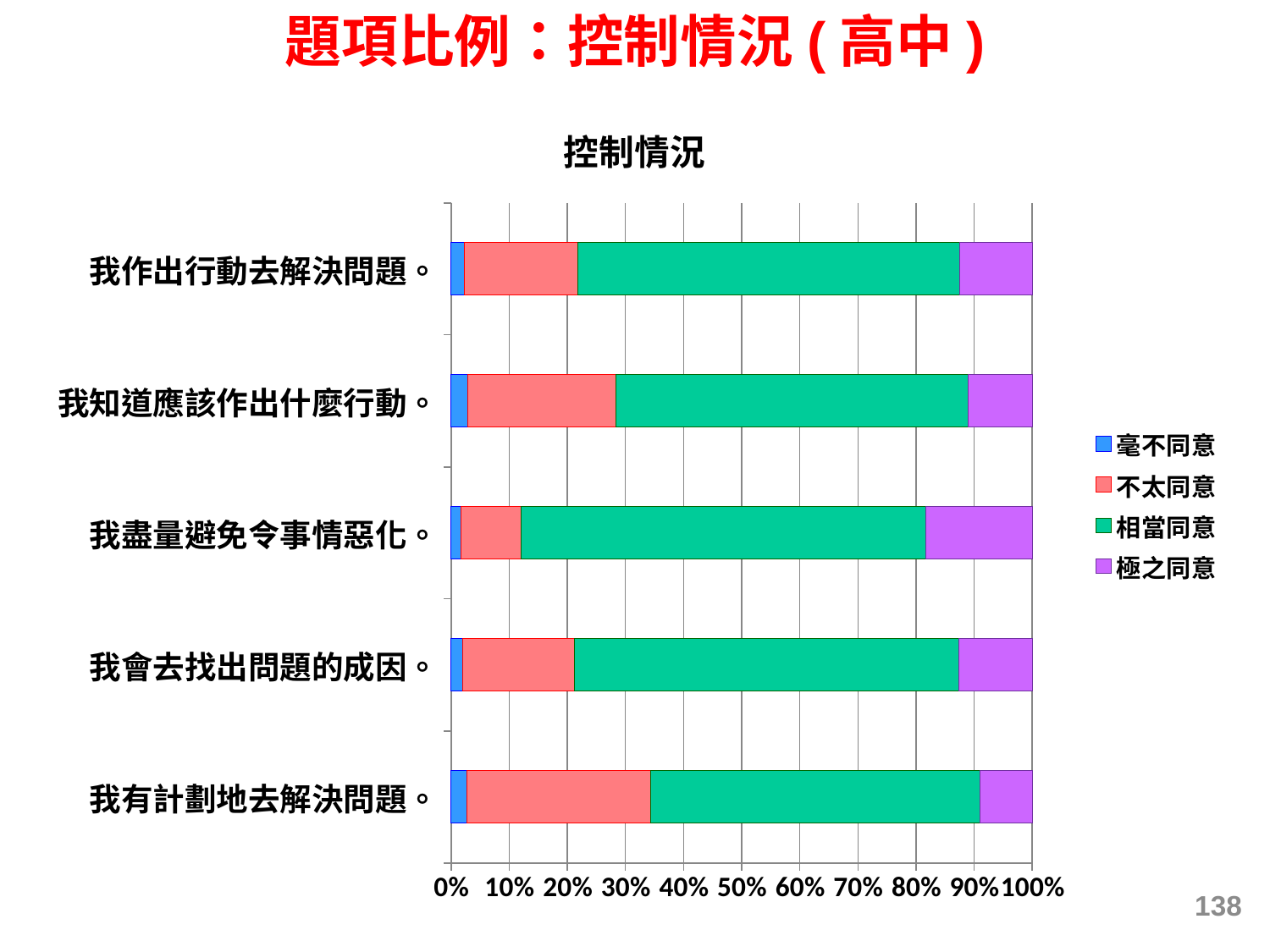
How many statements (categories) are plotted in the chart? 5 What kind of chart is shown on the slide? stacked bar chart What is the title of the chart? 控制情況 Is the 不太同意 share for 我盡量避免令事情惡化 greater or less than 20%? less Which has the larger 不太同意 share: 我有計劃地去解決問題 or 我盡量避免令事情惡化? 我有計劃地去解決問題。 Which statement has the largest 不太同意 share? 我有計劃地去解決問題。 Which legend entry is shown in green? 相當同意 Is the 極之同意 share for 我有計劃地去解決問題 greater or less than 20%? less Which statement has the smallest 不太同意 share? 我盡量避免令事情惡化。 Is the 不太同意 share for 我有計劃地去解決問題 greater or less than 20%? greater How many series does the legend list? 4